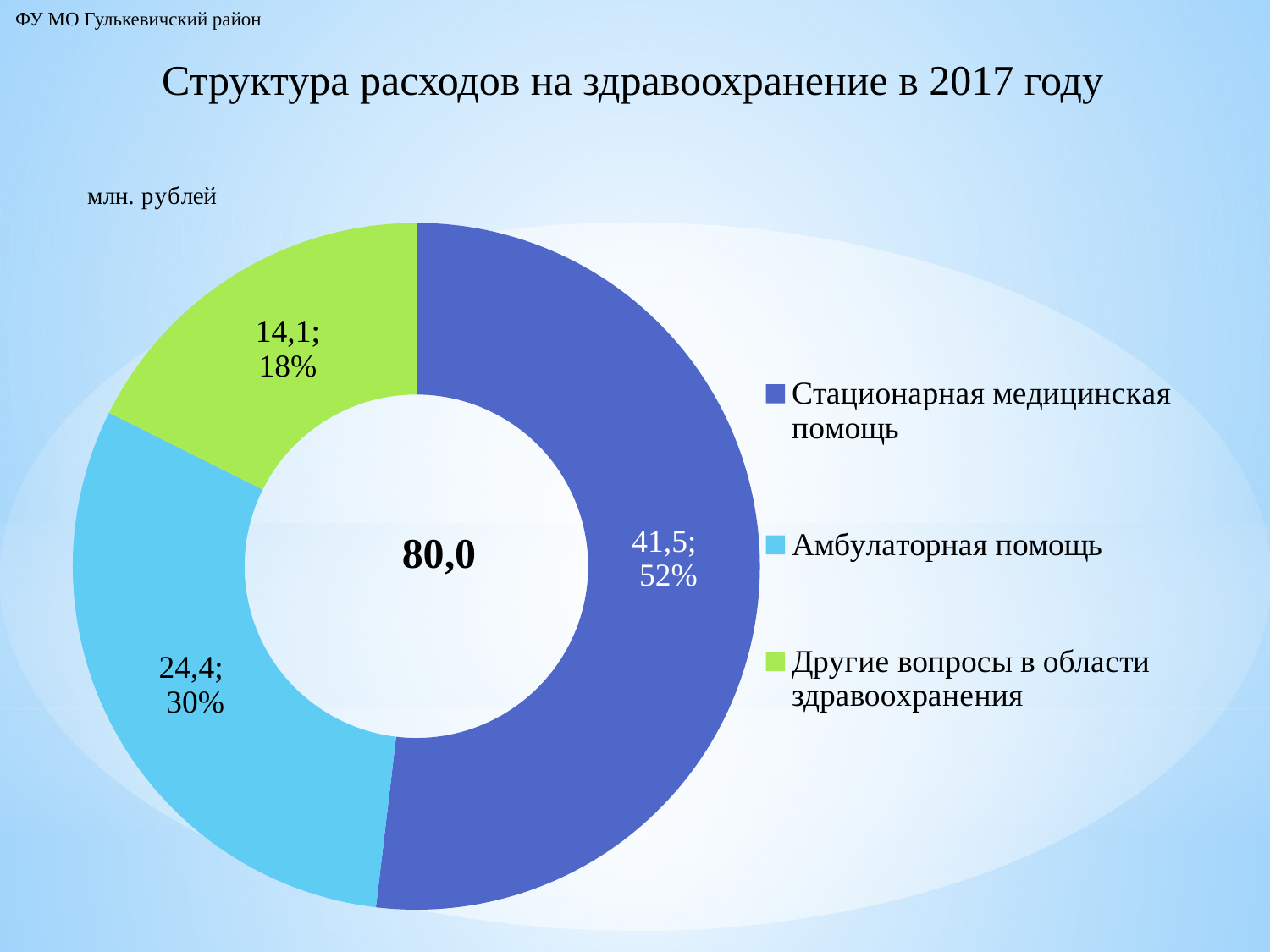
What share of the total does Другие вопросы в области здравоохранения account for? 18% What share of the total does Амбулаторная помощь account for? 30% How many categories does the chart show? 3 What is the value for Амбулаторная помощь? 24,4 What is the value for Стационарная медицинская помощь? 41,5 What share of the total does Стационарная медицинская помощь account for? 52% Which is larger, Амбулаторная помощь or Другие вопросы в области здравоохранения? Амбулаторная помощь What is the value for Другие вопросы в области здравоохранения? 14,1 Which category has the largest value? Стационарная медицинская помощь What is the difference between the values for Стационарная медицинская помощь and Амбулаторная помощь? 17,1 What kind of chart is shown on the slide? Pie chart (doughnut) Which category has the smallest value? Другие вопросы в области здравоохранения